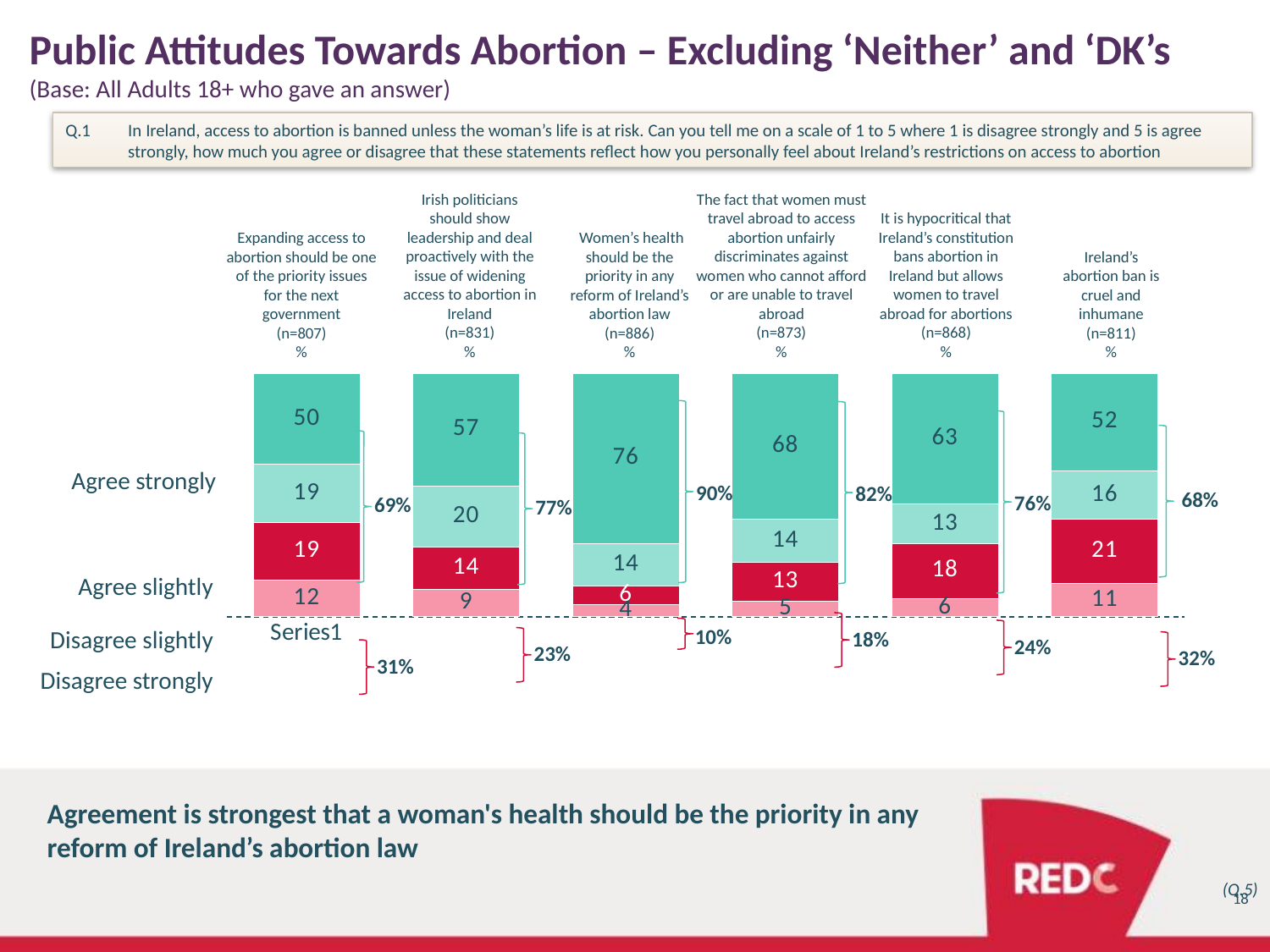
What is the total agreement percentage shown for the statement 'Irish politicians should show leadership and deal proactively with the issue of widening access to abortion in Ireland'? 77% What is the 'agree strongly' value for the statement 'Women's health should be the priority in any reform of Ireland's abortion law'? 76 What is the 'agree strongly' value for the statement 'Ireland's abortion ban is cruel and inhumane'? 52 How many statements (bars) are shown in the chart? 6 What kind of chart is shown on the slide? Stacked bar chart Which has a higher total disagreement percentage: 'It is hypocritical that Ireland's constitution bans abortion...' or 'The fact that women must travel abroad... discriminates...'? It is hypocritical that Ireland's constitution bans abortion (24%) What is the total disagreement percentage shown for the statement 'Ireland's abortion ban is cruel and inhumane'? 32% Which statement has the highest 'agree strongly' value? Women's health should be the priority in any reform of Ireland's abortion law What is the sample size (n) shown for the statement 'Women's health should be the priority in any reform of Ireland's abortion law'? n=886 What is the difference between the 'agree strongly' values for 'Women's health should be the priority' (76) and 'Expanding access to abortion should be one of the priority issues' (50)? 26 Which statement has the lowest total agreement percentage? Ireland's abortion ban is cruel and inhumane (68%) What is the total disagreement percentage shown for the statement 'Expanding access to abortion should be one of the priority issues for the next government'? 31%